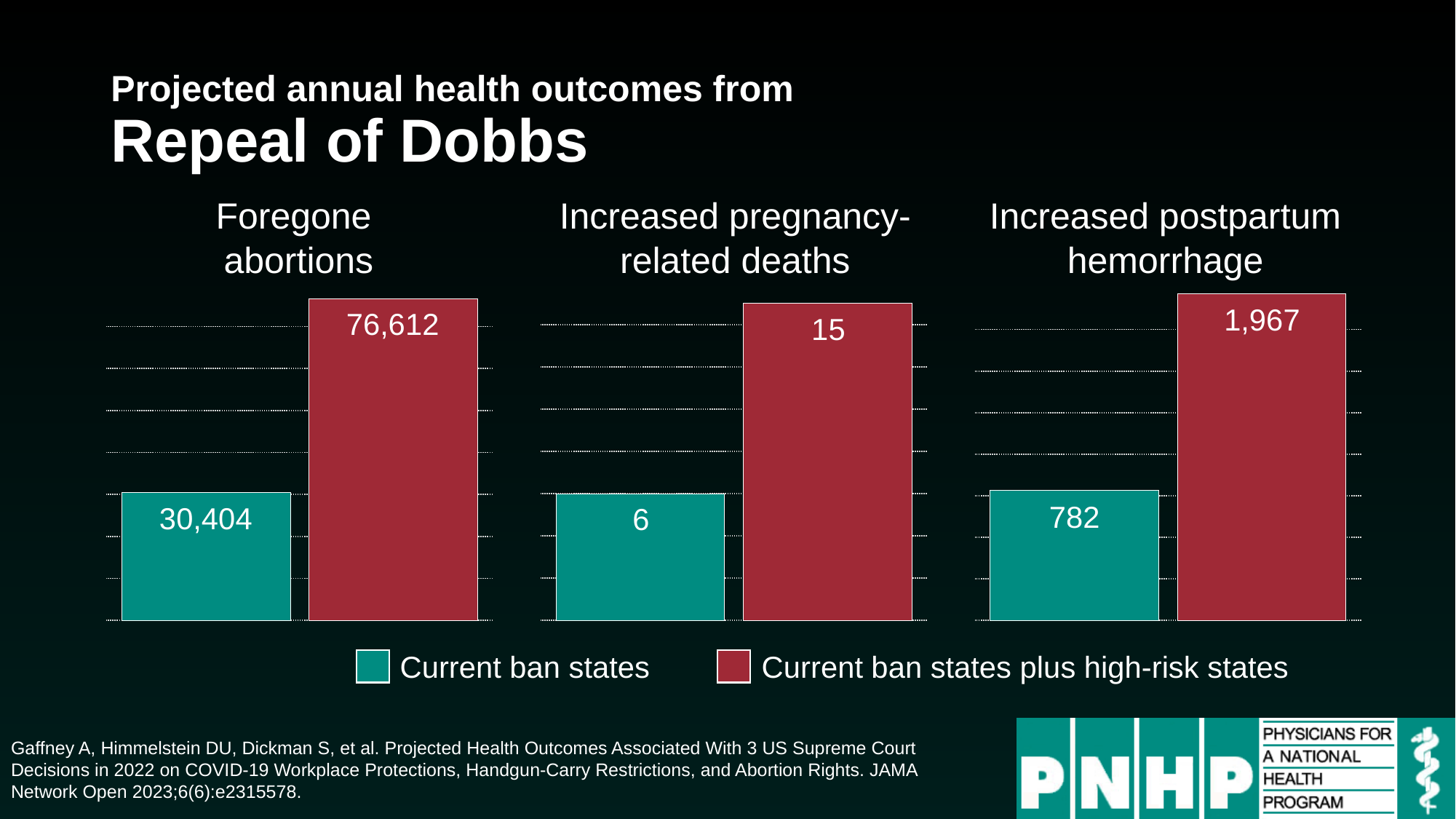
In the 'Foregone abortions' chart, what is the value for Current ban states plus high-risk states? 76,612 In the 'Increased postpartum hemorrhage' chart, which series has the larger value? Current ban states plus high-risk states In the 'Foregone abortions' chart, what is the value for Current ban states? 30,404 In the 'Increased pregnancy-related deaths' chart, what is the difference between the two bars? 9 In the 'Increased pregnancy-related deaths' chart, what is the value for Current ban states? 6 In the 'Increased pregnancy-related deaths' chart, what is the value for Current ban states plus high-risk states? 15 What colour represents Current ban states in the legend? Teal In the 'Foregone abortions' chart, what is the difference between the Current ban states plus high-risk states value and the Current ban states value? 46,208 In the 'Increased postpartum hemorrhage' chart, what is the value for Current ban states? 782 In the 'Increased postpartum hemorrhage' chart, what is the value for Current ban states plus high-risk states? 1,967 How many series does the legend list? 2 What kind of chart is used on this slide? Bar chart